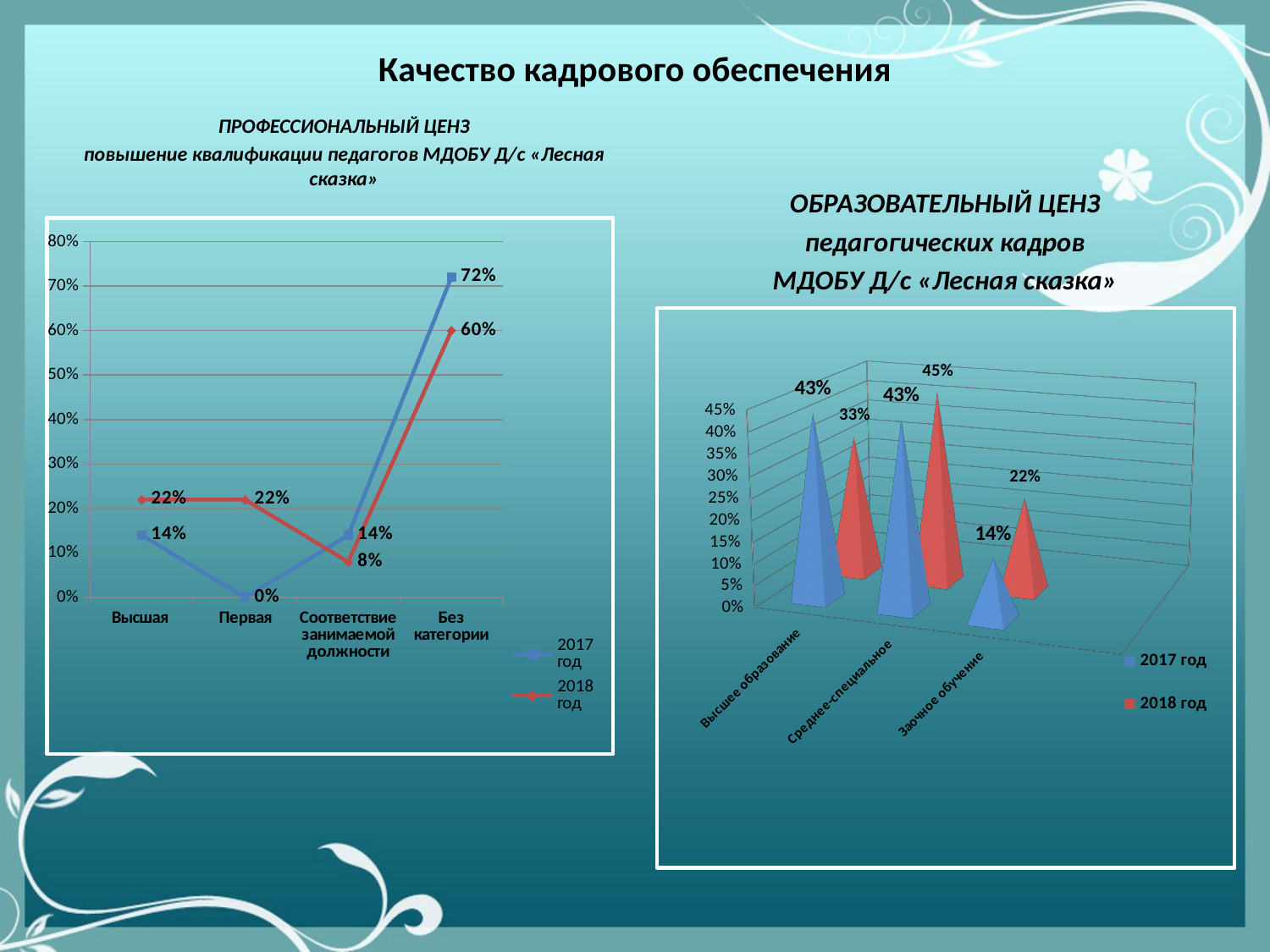
How many series does the legend of the right chart (ОБРАЗОВАТЕЛЬНЫЙ ЦЕНЗ) list? 2 How many categories are shown on the x axis of the left chart (ПРОФЕССИОНАЛЬНЫЙ ЦЕНЗ)? 4 On the left chart (ПРОФЕССИОНАЛЬНЫЙ ЦЕНЗ), what is the value for Первая in 2018 год? 22% On the right chart (ОБРАЗОВАТЕЛЬНЫЙ ЦЕНЗ), which category has the highest value for 2018 год? Среднее-специальное On the right chart (ОБРАЗОВАТЕЛЬНЫЙ ЦЕНЗ), what is the value for Заочное обучение in 2018 год? 22% On the left chart (ПРОФЕССИОНАЛЬНЫЙ ЦЕНЗ), what is the value for Соответствие занимаемой должности in 2018 год? 8% What kind of chart is the left chart (ПРОФЕССИОНАЛЬНЫЙ ЦЕНЗ)? line chart On the left chart (ПРОФЕССИОНАЛЬНЫЙ ЦЕНЗ), which category has the lowest value for 2017 год? Первая On the left chart (ПРОФЕССИОНАЛЬНЫЙ ЦЕНЗ), which is larger for Высшая: 2017 год or 2018 год? 2018 год On the right chart (ОБРАЗОВАТЕЛЬНЫЙ ЦЕНЗ), what is the value for Высшее образование in 2017 год? 43% On the left chart (ПРОФЕССИОНАЛЬНЫЙ ЦЕНЗ), what is the value for Без категории in 2017 год? 72% On the left chart (ПРОФЕССИОНАЛЬНЫЙ ЦЕНЗ), what is the difference between the 2017 год and 2018 год values for Без категории? 12%